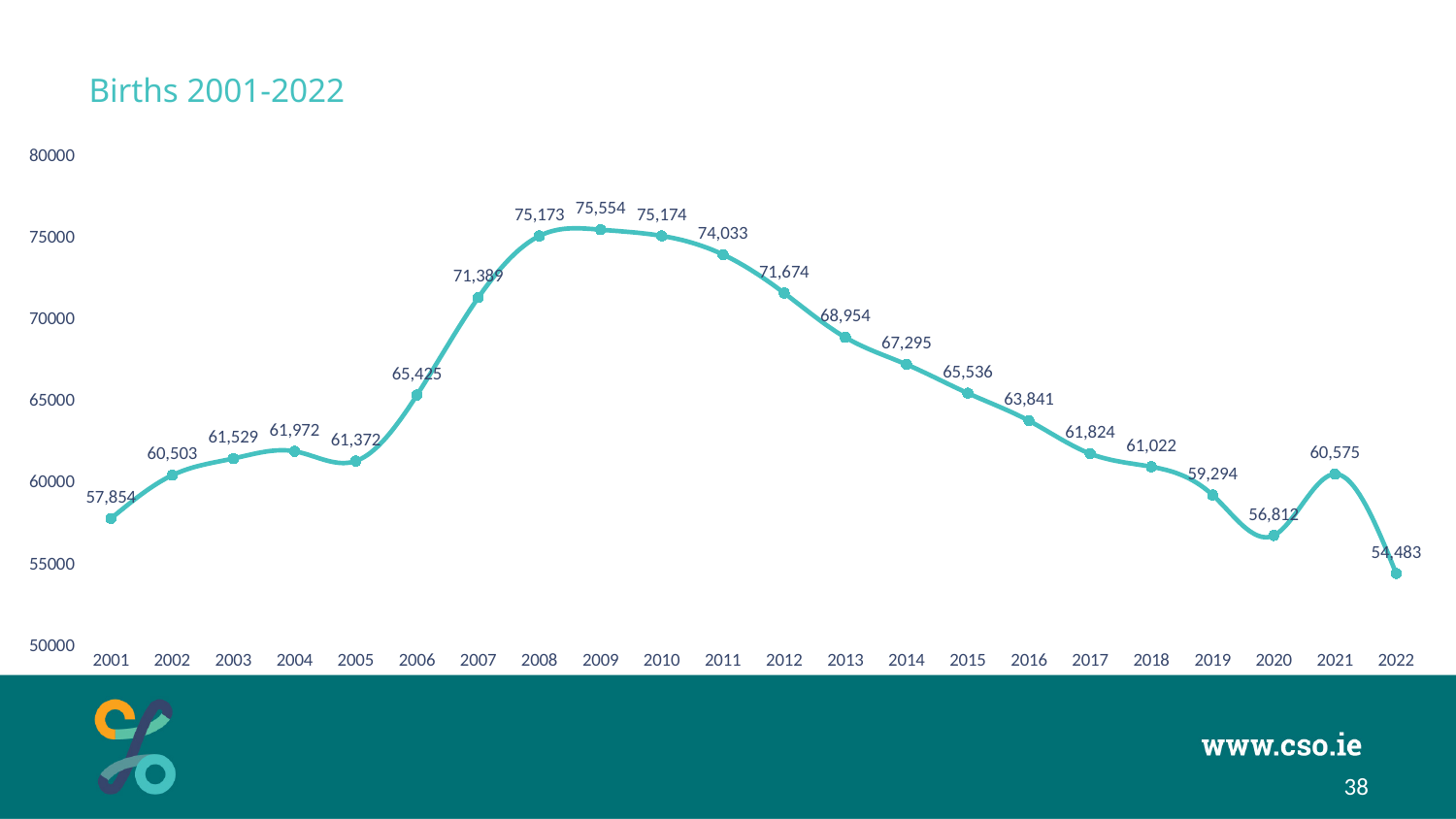
Which is larger, the value for 2007 or the value for 2013? 2007 Which year has the highest number of births? 2009 What is the value for 2020? 56,812 What type of chart is shown on the slide? Line chart What is the title of the chart? Births 2001-2022 What is the difference between the values for 2021 and 2020? 3,763 What is the difference between the values for 2009 and 2022? 21,071 How many years are plotted on the chart? 22 What is the value for 2001? 57,854 What is the value for 2022? 54,483 Which year has the lowest number of births? 2022 What is the value for 2009? 75,554